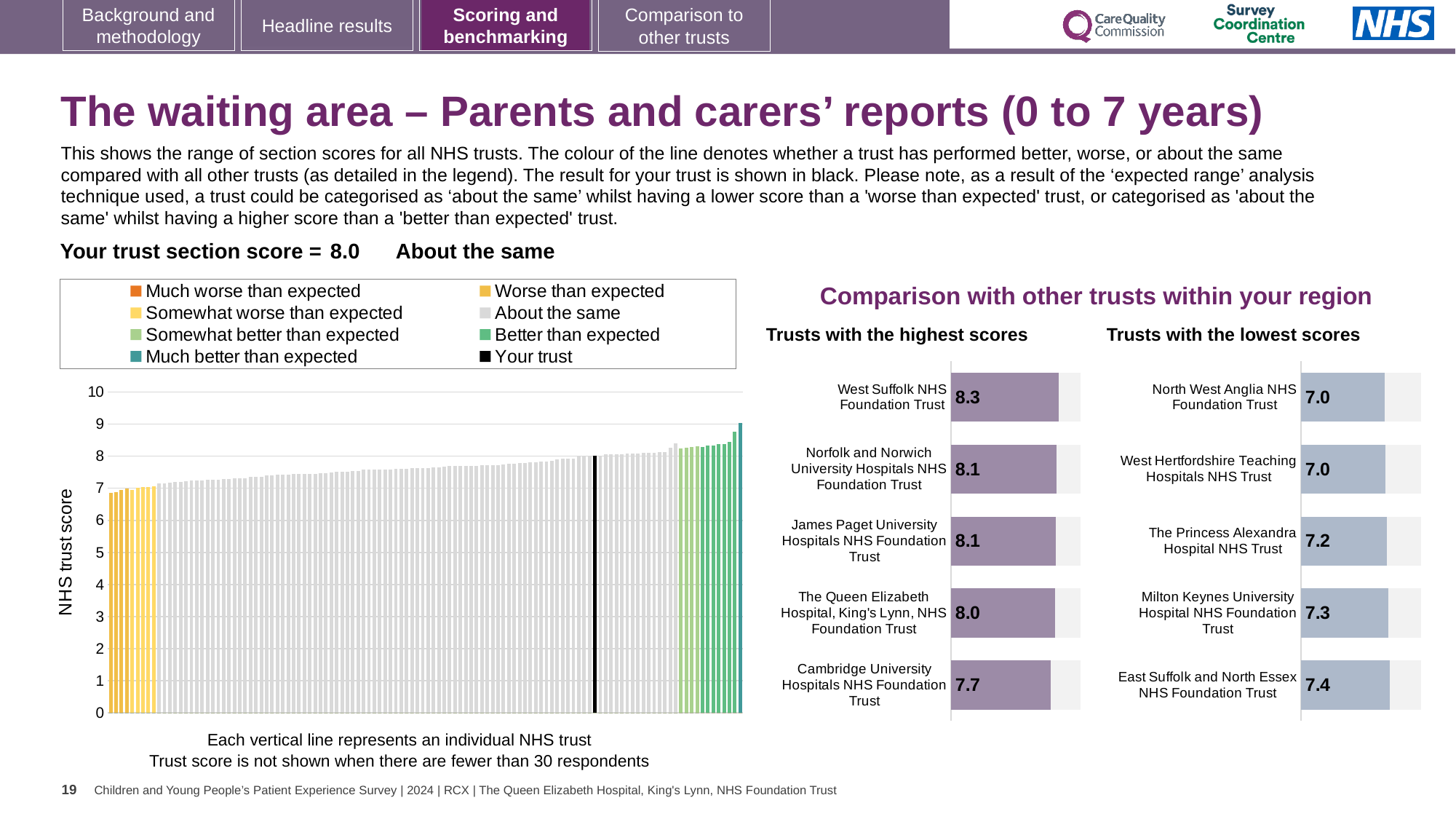
In the NHS trust score chart on the left, what is the score for your trust (the black bar)? 8.0 In the 'Trusts with the lowest scores' chart, which trust has the highest score? East Suffolk and North Essex NHS Foundation Trust In the NHS trust score chart on the left, do the trust scores rise or fall from left to right along the x axis? rise In the 'Trusts with the lowest scores' chart, what is the difference between the scores of East Suffolk and North Essex NHS Foundation Trust and North West Anglia NHS Foundation Trust? 0.4 How many trusts are shown in the 'Trusts with the highest scores' chart? 5 In the 'Trusts with the highest scores' chart, what is the score for Cambridge University Hospitals NHS Foundation Trust? 7.7 In the 'Trusts with the highest scores' chart, which trust has the lowest score? Cambridge University Hospitals NHS Foundation Trust In the 'Trusts with the highest scores' chart, what is the difference between the scores of West Suffolk NHS Foundation Trust and The Queen Elizabeth Hospital, King's Lynn, NHS Foundation Trust? 0.3 In the 'Trusts with the lowest scores' chart, which has the larger score: The Princess Alexandra Hospital NHS Trust or West Hertfordshire Teaching Hospitals NHS Trust? The Princess Alexandra Hospital NHS Trust How many entries does the legend of the NHS trust score chart on the left list? 8 In the 'Trusts with the lowest scores' chart, what is the score for Milton Keynes University Hospital NHS Foundation Trust? 7.3 In the 'Trusts with the highest scores' chart, what is the score for West Suffolk NHS Foundation Trust? 8.3